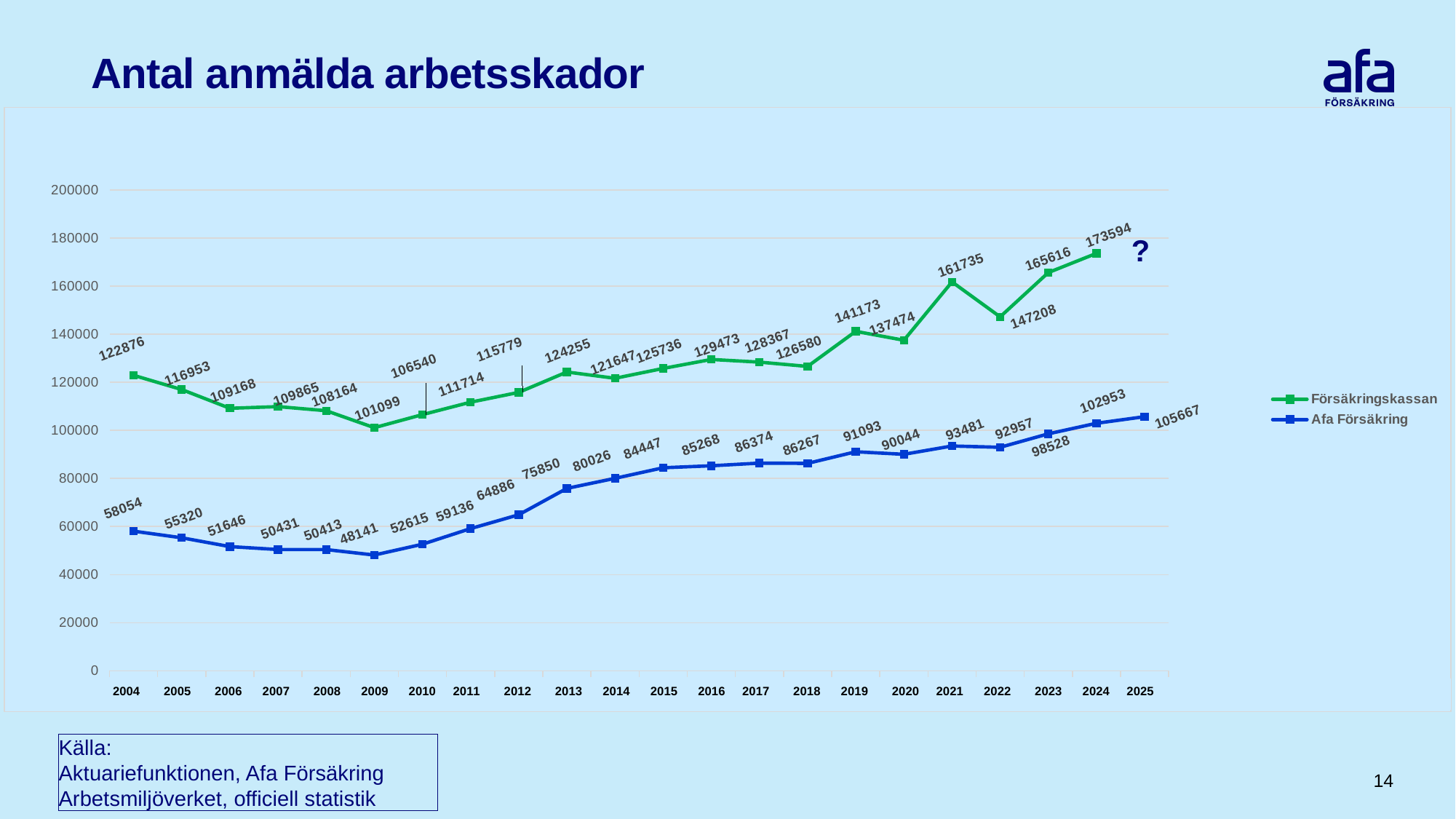
What is the title of the chart? Antal anmälda arbetsskador Which is larger: the Försäkringskassan value in 2022 or in 2021? 2021 What type of chart is shown on the slide? Line chart What is the difference between the Försäkringskassan value in 2024 and in 2023? 7978 What is the value for Afa Försäkring in 2025? 105667 In which year is the Afa Försäkring series at its lowest? 2009 In which year is the Försäkringskassan series at its highest? 2024 What is the value for Afa Försäkring in 2009? 48141 What is the value for Försäkringskassan in 2024? 173594 What is the value for Försäkringskassan in 2021? 161735 How many series does the legend list? 2 Does the Afa Försäkring series generally rise or fall from 2009 to 2025? Rise